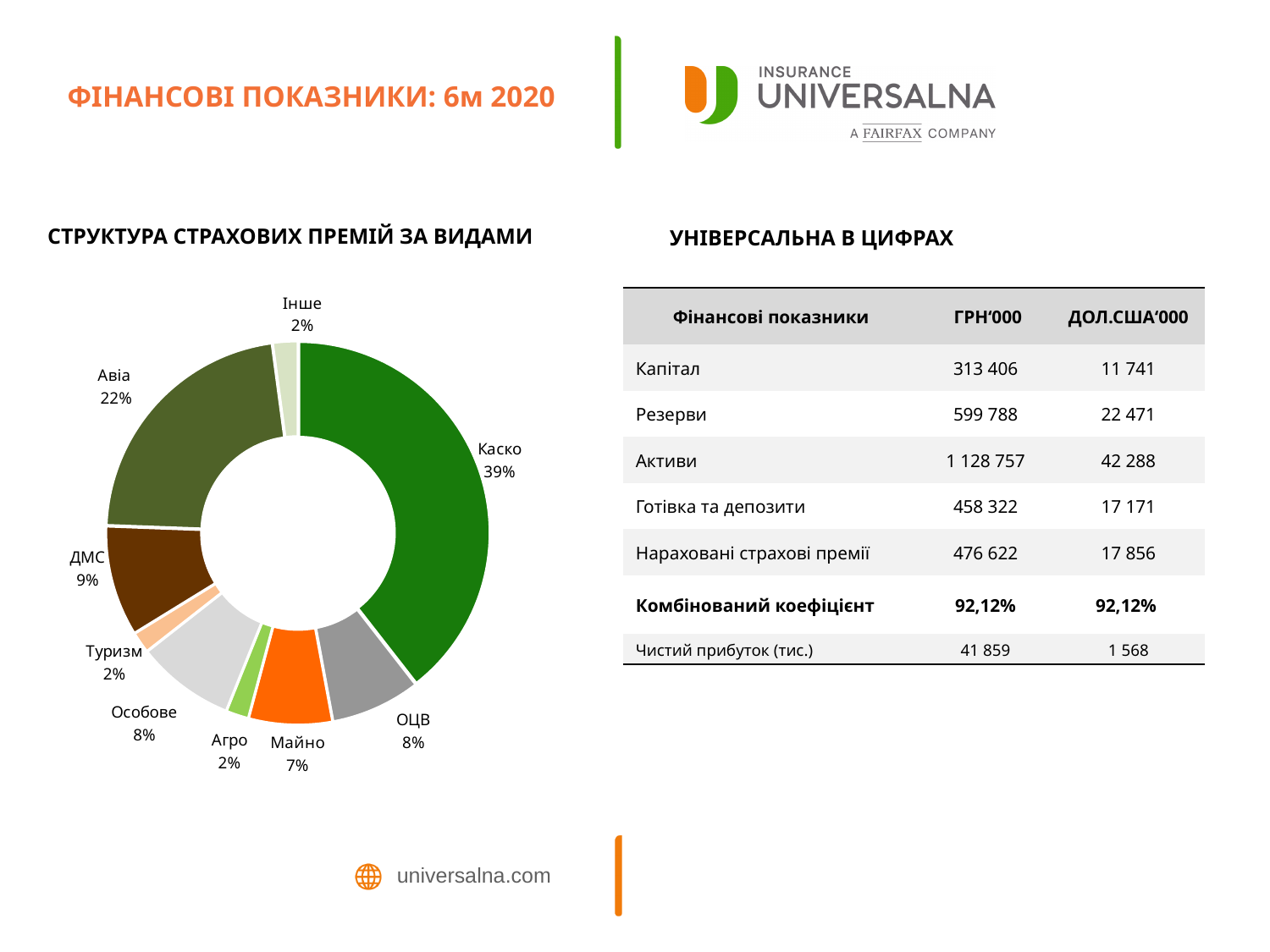
What share of insurance premiums does Каско account for in the chart? 39% What is the difference in percentage points between Каско and Авіа? 17 What is the value shown for Авіа in the chart? 22% Which is larger in the chart, Авіа or ОЦВ? Авіа What is the value shown for Майно in the chart? 7% Which category has the largest share in the chart? Каско What is the combined share of Каско and Авіа in the chart? 61% What percentage is shown for ДМС in the chart? 9% What is the title of the chart on the slide? СТРУКТУРА СТРАХОВИХ ПРЕМІЙ ЗА ВИДАМИ What kind of chart is used to show the structure of insurance premiums by type? Pie chart (donut) Which is larger in the chart, ДМС or Особове? ДМС How many categories are shown in the chart? 9